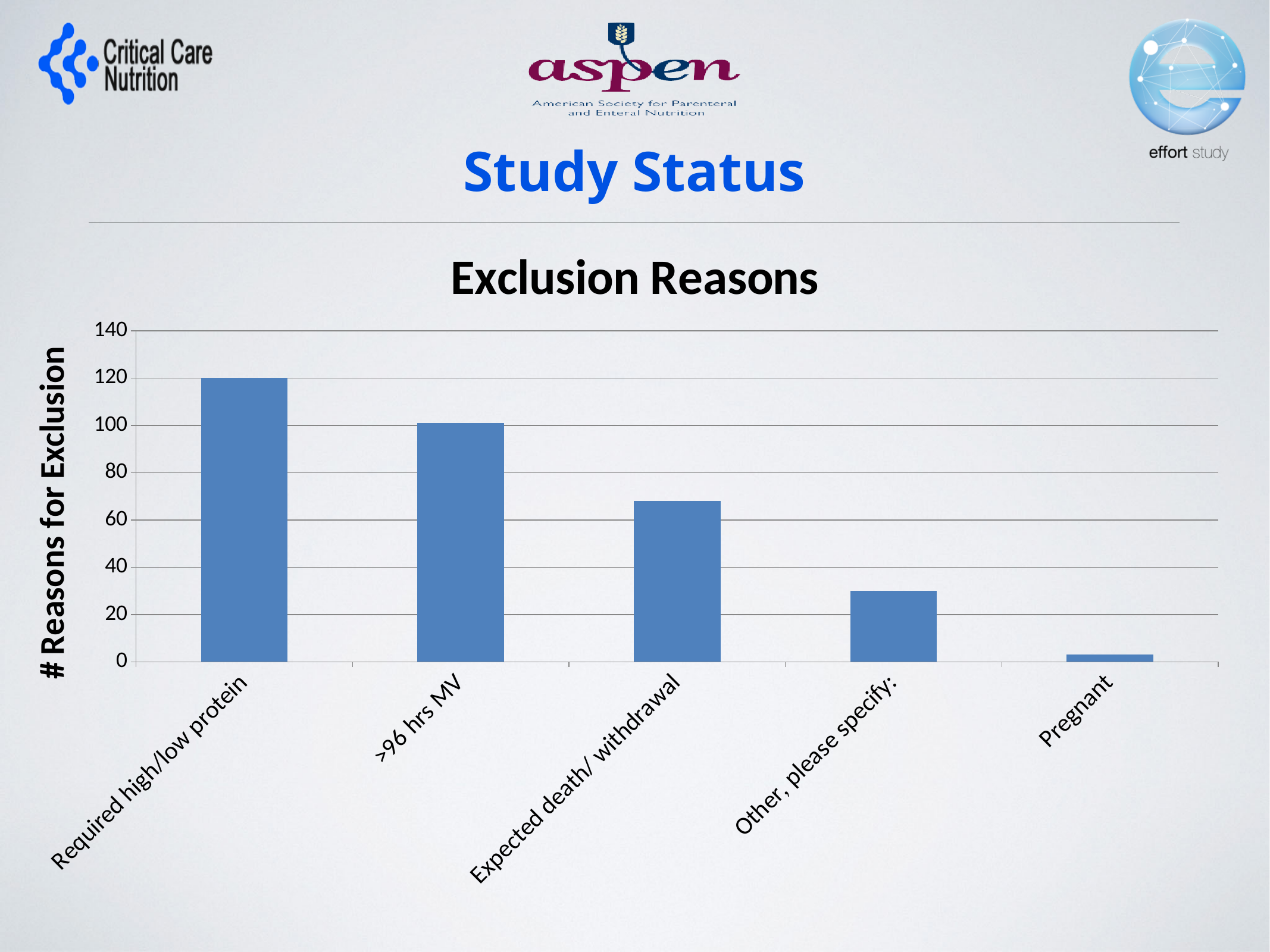
Which exclusion reason has the highest number of exclusions? Required high/low protein Which exclusion reason has the lowest number of exclusions? Pregnant What kind of chart is shown on the slide? bar chart What is the title of the chart? Exclusion Reasons Is the value for Other, please specify: greater or less than 40? less Is the value for >96 hrs MV greater or less than 120? less What is the value for Required high/low protein? 120 Do the values rise or fall from left to right across the categories? fall What is the label of the vertical axis? # Reasons for Exclusion Which is larger, the value for >96 hrs MV or the value for Expected death/ withdrawal? >96 hrs MV Is the value for Expected death/ withdrawal greater or less than 60? greater How many exclusion reason categories are plotted? 5